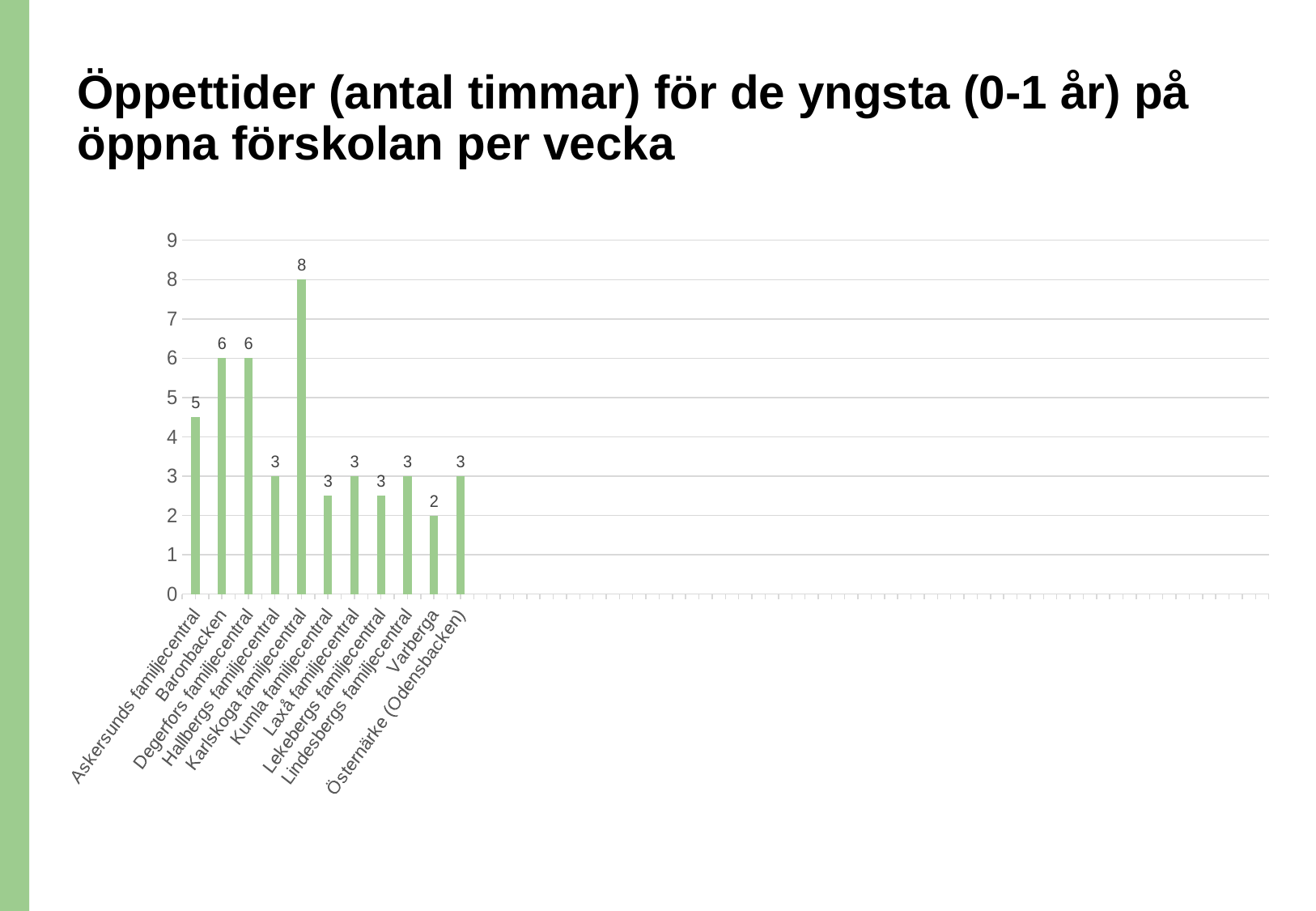
What is the value shown for Baronbacken? 6 What is the difference between the values for Karlskoga familjecentral and Varberga? 6 What is the value shown for Askersunds familjecentral? 5 Which is larger, the value for Degerfors familjecentral or the value for Hallbergs familjecentral? Degerfors familjecentral What is the title of the slide? Öppettider (antal timmar) för de yngsta (0-1 år) på öppna förskolan per vecka Which category has the lowest value in the chart? Varberga How many categories (open preschools) are plotted in the chart? 11 Is the value for Karlskoga familjecentral greater or less than 7? greater What is the value shown for Varberga? 2 What kind of chart is shown on the slide? bar chart Which category has the highest value in the chart? Karlskoga familjecentral What is the value shown for Karlskoga familjecentral? 8